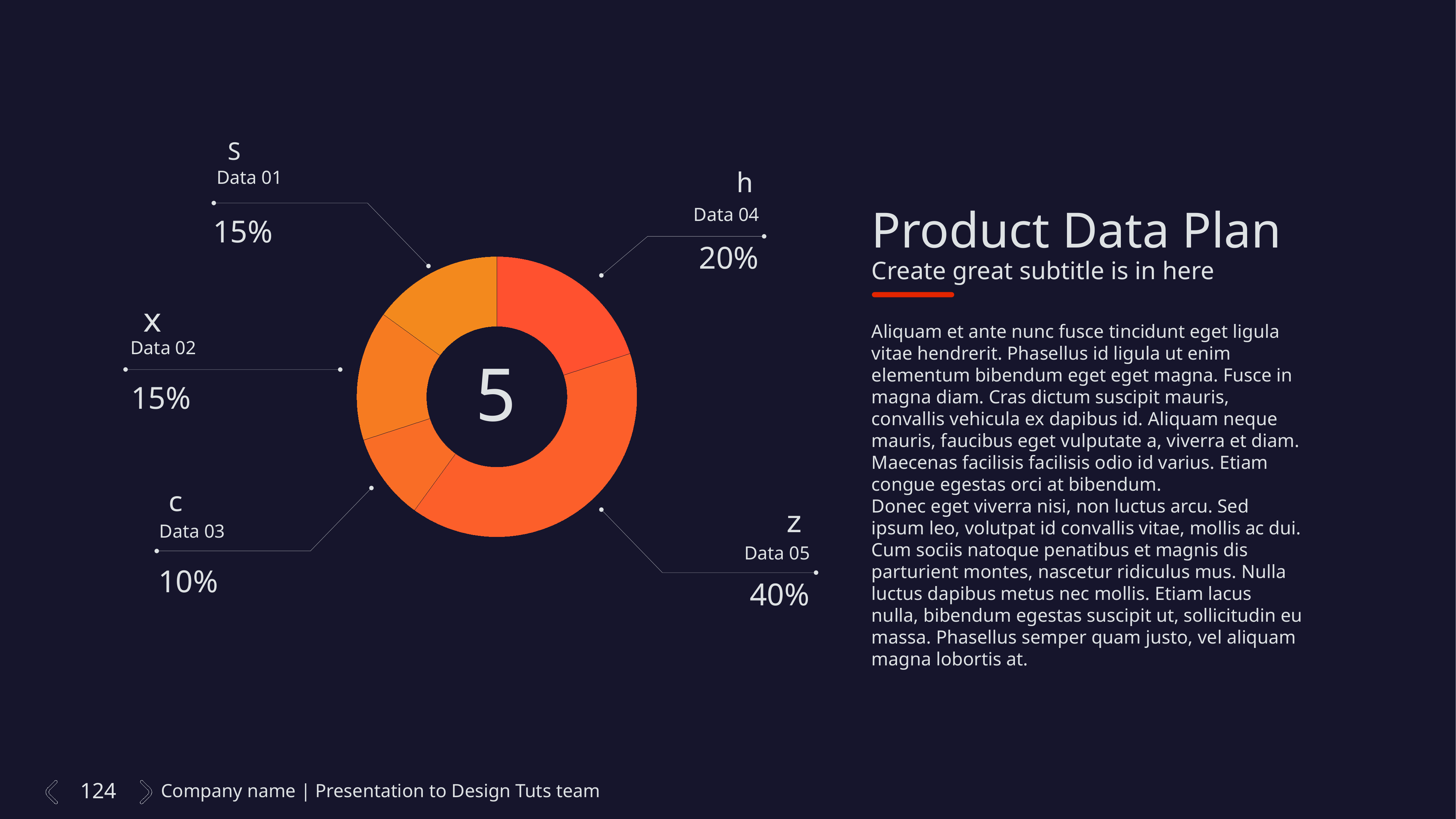
What number is printed in the centre of the donut chart? 5 What is the value for Data 05? 40% Which is larger, the value for Data 04 or the value for Data 03? Data 04 Which category has the largest share of the donut chart? Data 05 Which category has the smallest share of the donut chart? Data 03 What is the difference between the values for Data 05 and Data 04? 20% What is the value for Data 01? 15% What is the value for Data 04? 20% What is the value for Data 03? 10% What type of chart is shown on the slide? Donut chart What is the title of the slide containing the donut chart? Product Data Plan How many segments does the donut chart have? 5